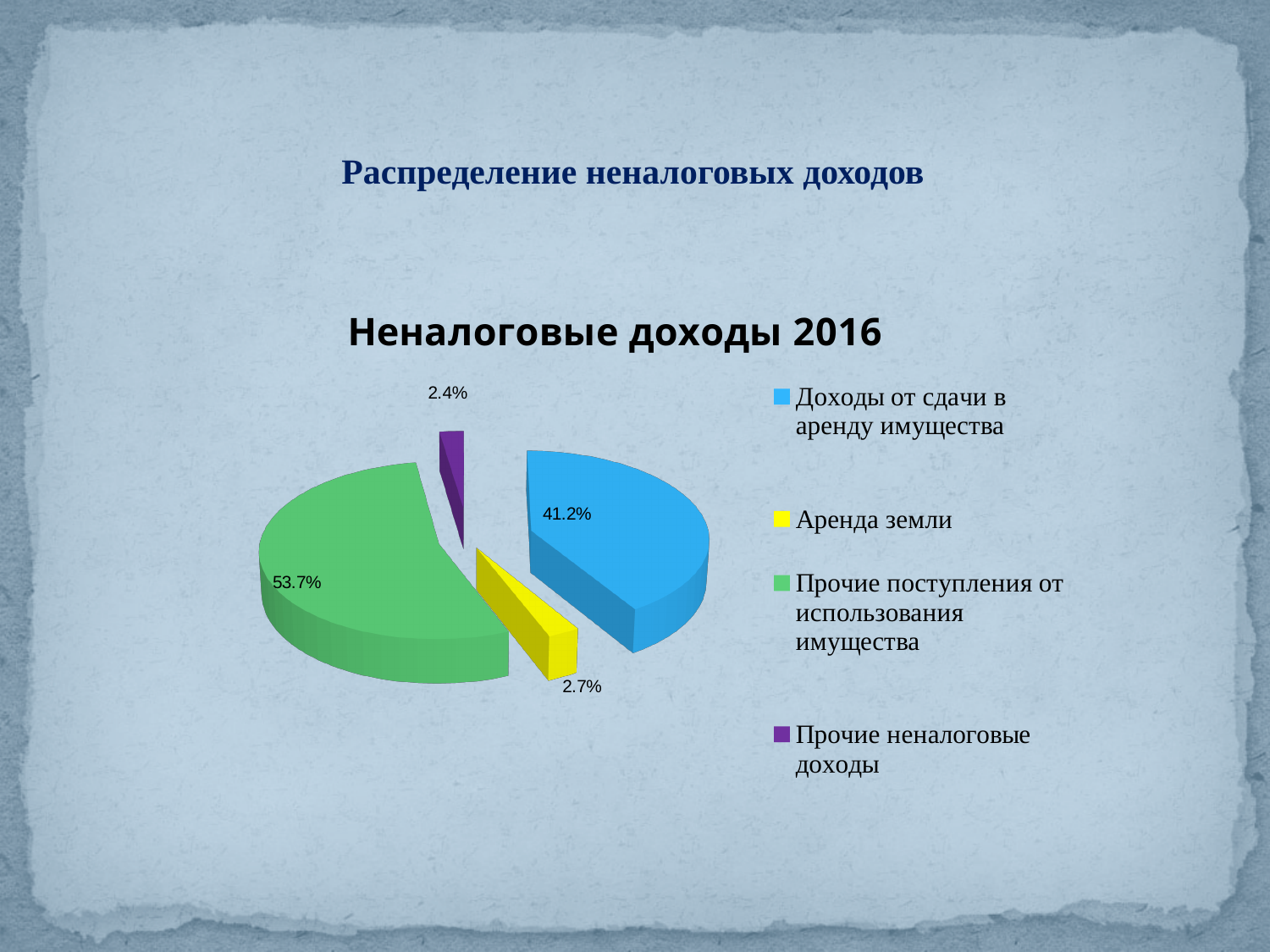
How many categories does the legend list? 4 Which category has the largest share of the pie? Прочие поступления от использования имущества What kind of chart is shown on the slide? Pie chart Which category has the smallest share of the pie? Прочие неналоговые доходы What colour is the slice for 'Аренда земли'? Yellow What share of the pie is 'Прочие поступления от использования имущества'? 53.7% What share of the pie is 'Аренда земли'? 2.7% Which is larger: 'Доходы от сдачи в аренду имущества' or 'Аренда земли'? Доходы от сдачи в аренду имущества What share of the pie is 'Доходы от сдачи в аренду имущества'? 41.2% What is the difference in percentage points between 'Прочие поступления от использования имущества' and 'Доходы от сдачи в аренду имущества'? 12.5 What share of the pie is 'Прочие неналоговые доходы'? 2.4% What is the title of the chart? Неналоговые доходы 2016